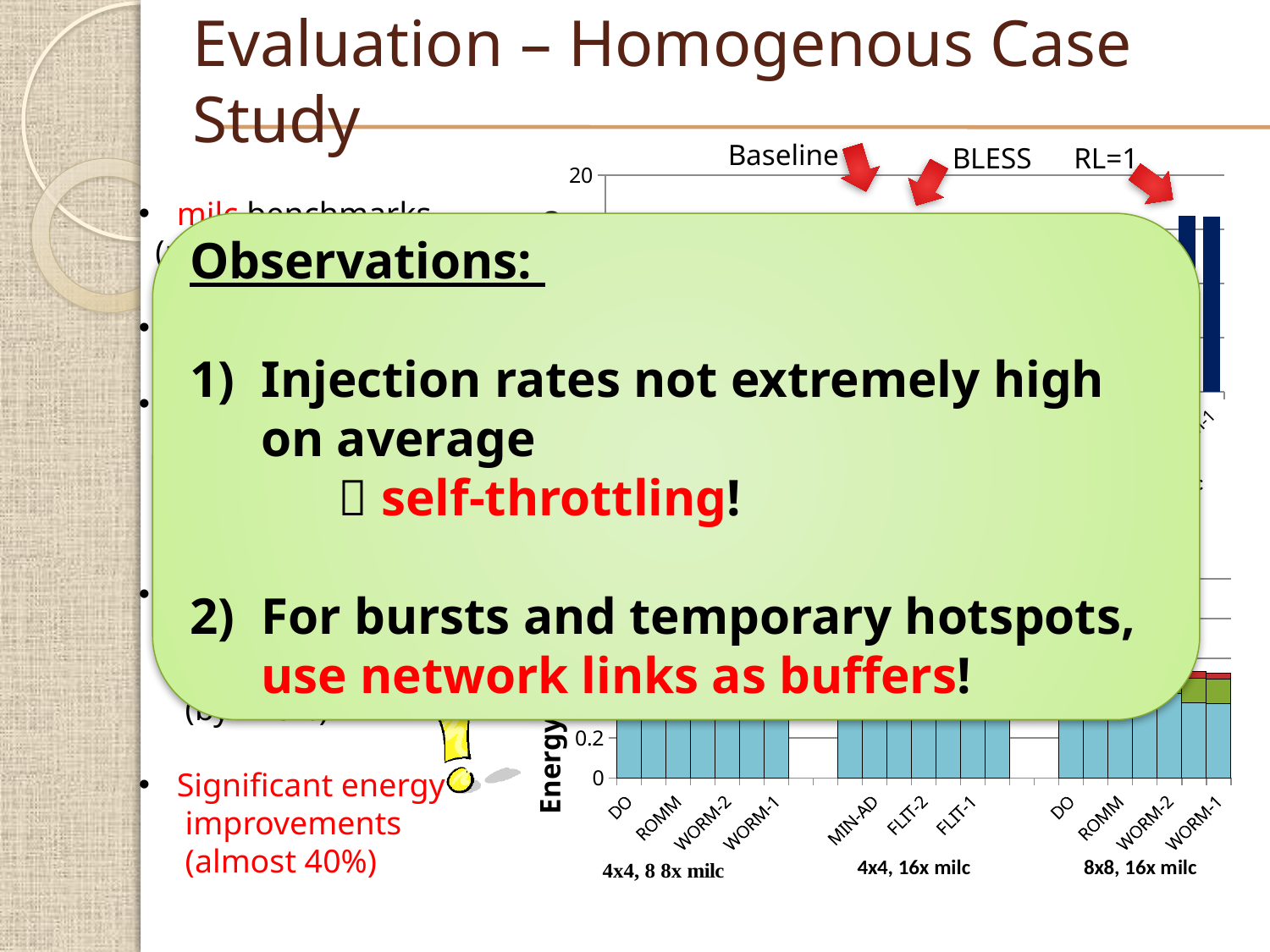
In the lower chart, how many categories are in the 4x4, 16x milc group? 3 In the lower chart, is the value for MIN-AD in the 4x4, 16x milc group greater or less than 0.2? greater In the lower chart, is the value for DO in the 4x4, 8 8x milc group greater or less than 0.2? greater What kind of chart is the lower chart on the slide? bar chart What is the topmost y-axis tick value shown on the upper chart? 20 In the lower chart, how many groups of bars are labelled along the x axis? 3 In the lower chart, what is the label on the y axis? Energy In the lower chart, how many categories are in the 8x8, 16x milc group? 4 In the lower chart, is the value for WORM-1 in the 8x8, 16x milc group greater or less than 0.2? greater